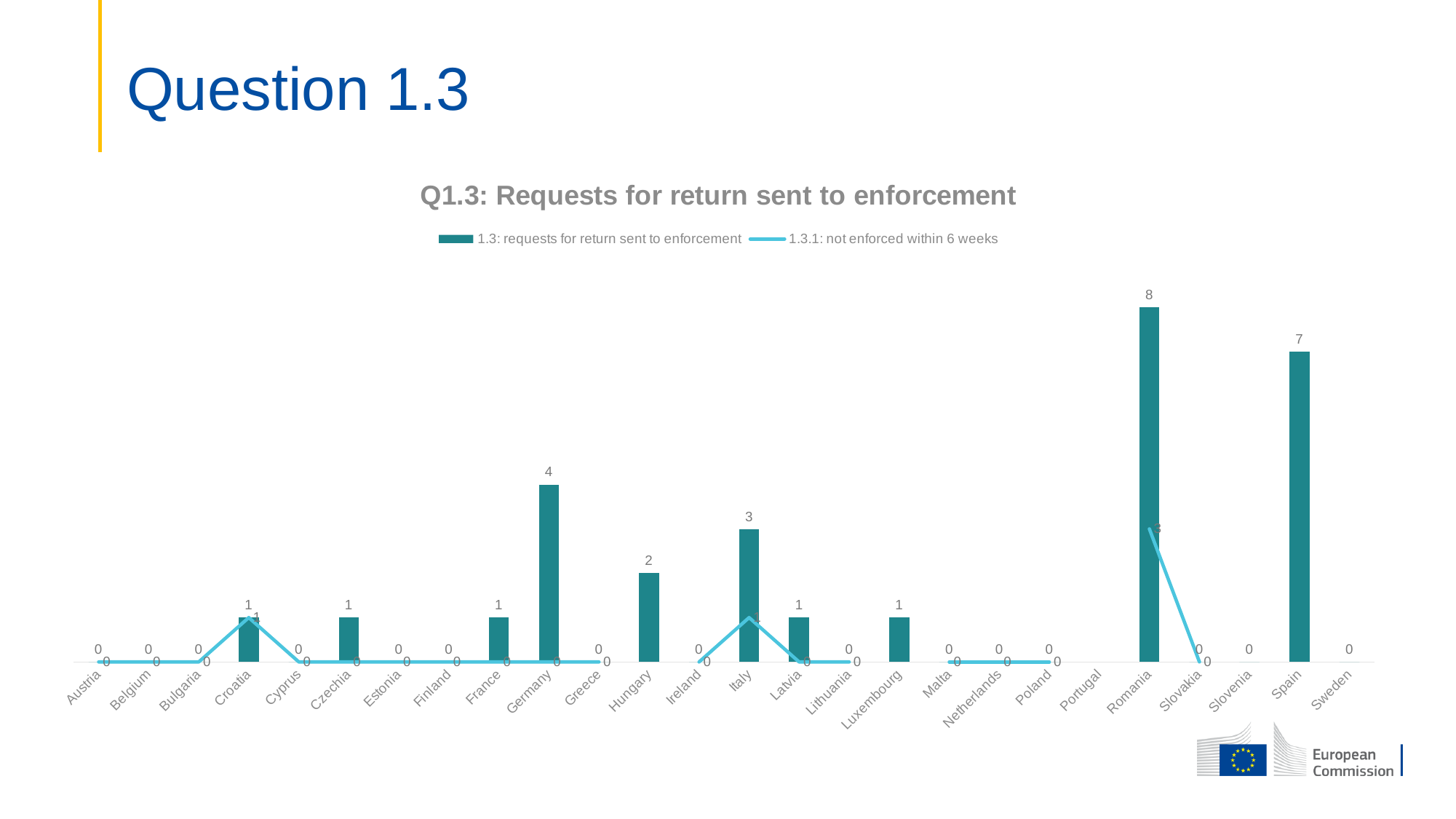
What is the title of the chart? Q1.3: Requests for return sent to enforcement What is the value of the bar for Romania in the '1.3: requests for return sent to enforcement' series? 8 What is the value of the '1.3.1: not enforced within 6 weeks' line for Italy? 1 Which has a larger bar value, Germany or Hungary? Germany What is the value of the '1.3.1: not enforced within 6 weeks' line for Croatia? 1 What is the value of the bar for Germany in the '1.3: requests for return sent to enforcement' series? 4 What is the value of the bar for Spain in the '1.3: requests for return sent to enforcement' series? 7 How many countries are listed on the x axis of the chart? 26 What is the difference between the bar values for Romania and Spain? 1 How many series does the legend list? 2 What is the value of the bar for Italy in the '1.3: requests for return sent to enforcement' series? 3 Which country has the highest bar for requests for return sent to enforcement? Romania